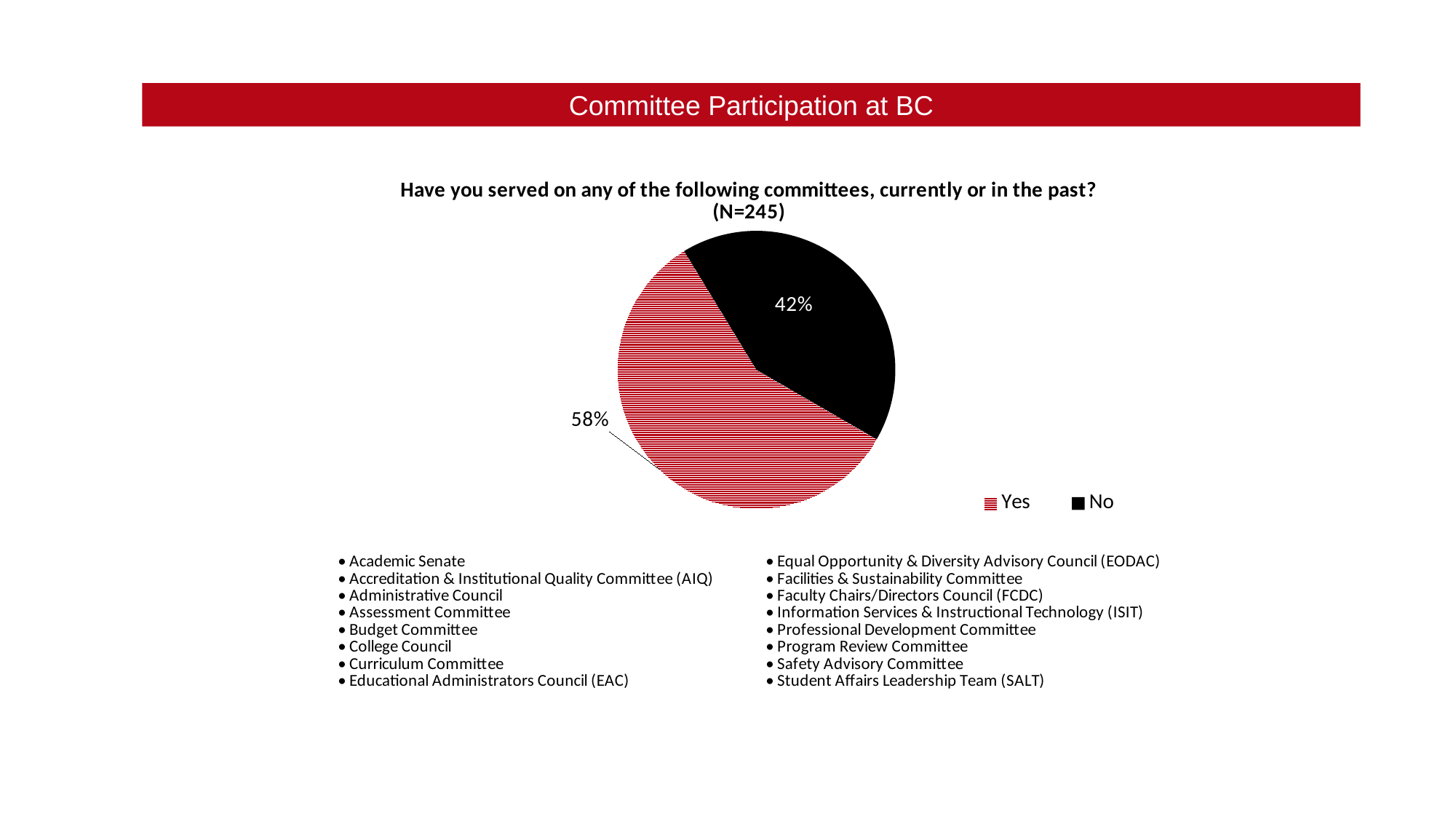
Which colour represents the No slice in the pie chart? black What kind of chart is shown on the slide? pie chart How many slices does the pie chart have? 2 What is the difference in percentage points between the Yes and No shares? 16 What is the N (number of respondents) shown in the chart title? 245 Which response has the larger share of the pie? Yes How many entries does the legend list? 2 What percentage of respondents answered Yes? 58% What percentage of respondents answered No? 42% Is the share for Yes larger or smaller than the share for No? larger Is the share for No greater or less than 50%? less Which response has the smaller share of the pie? No